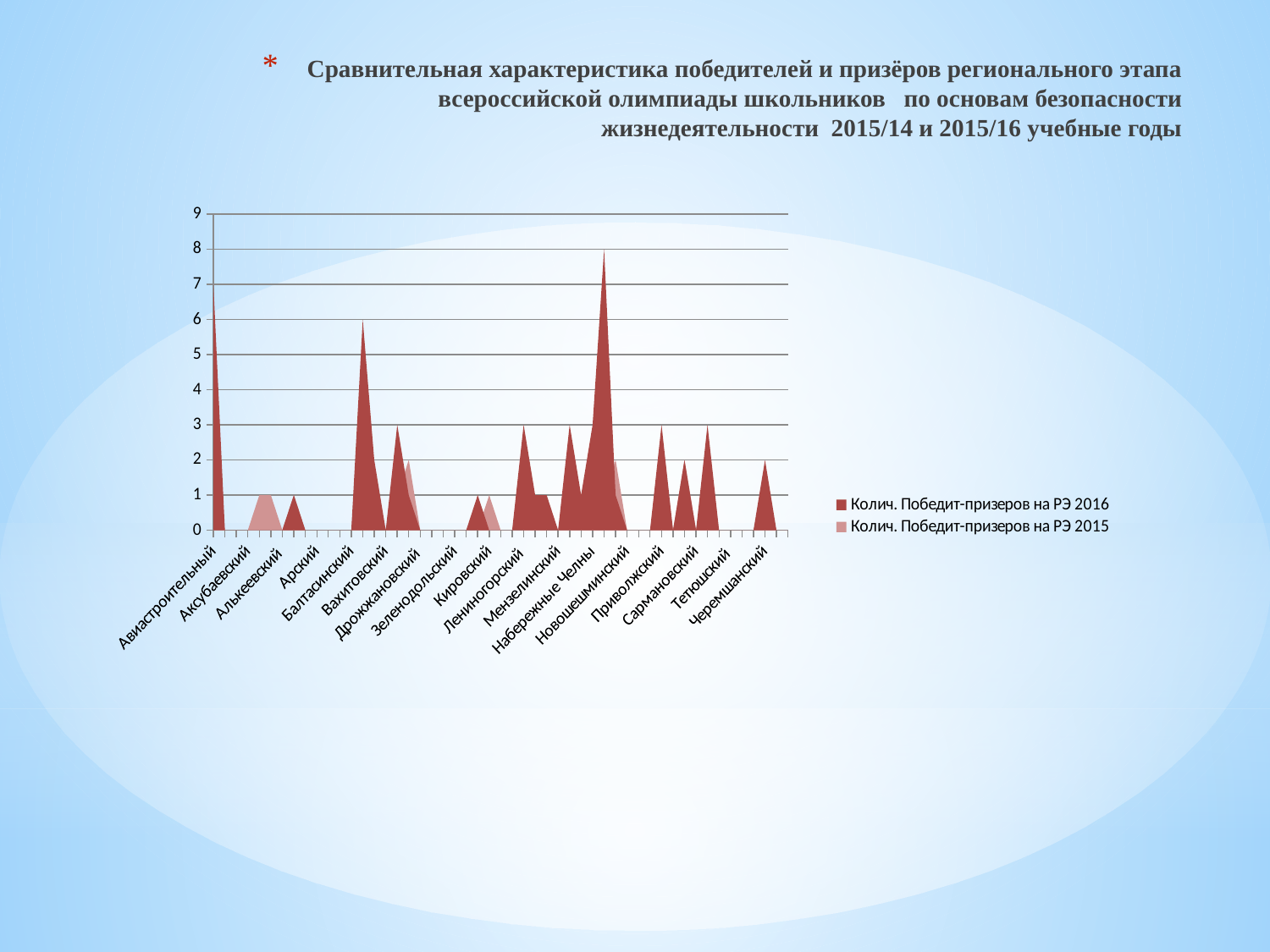
Is the value for Приволжский in the series 'Колич. Победит-призеров на РЭ 2016' greater or less than 5? less Which is larger for the series 'Колич. Победит-призеров на РЭ 2016': the value for Набережные Челны or the value for Авиастроительный? Авиастроительный Is the value for Вахитовский in the series 'Колич. Победит-призеров на РЭ 2016' greater or less than 4? less Is the value for Набережные Челны in the series 'Колич. Победит-призеров на РЭ 2016' greater or less than 5? less Which series is drawn in the lighter pink colour? Колич. Победит-призеров на РЭ 2015 How many series does the legend list? 2 What is the maximum value shown on the vertical axis? 9 Which is larger for the series 'Колич. Победит-призеров на РЭ 2016': the value for Вахитовский or the value for Черемшанский? Черемшанский What kind of chart is shown on the slide? Area chart